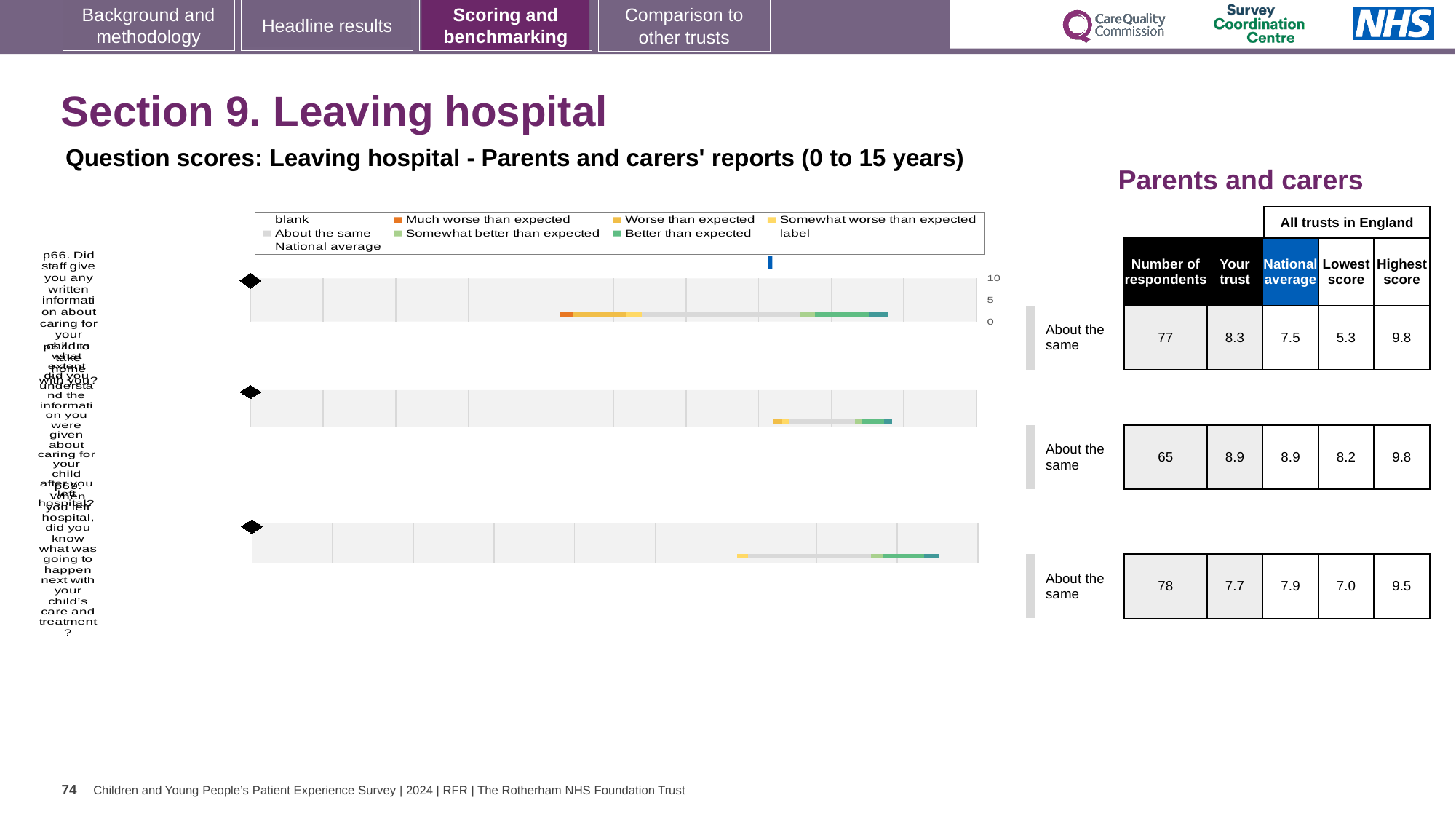
For the first (top) question row, what is the 'Your trust' score? 8.3 For the second (middle) question row, how many respondents are there? 65 What kind of chart is used to show the benchmark ranges on this slide? bar chart Which question row has the fewest respondents? the second (middle) row For the third (bottom) question row, what is the lowest score across all trusts in England? 7.0 For the third (bottom) question row, is the 'Your trust' score or the national average higher? national average For the first (top) question row, what is the national average score? 7.5 How many benchmark bar charts are shown on the slide? 3 In the chart legend, which colour represents 'Much worse than expected'? orange What is the title of the table to the right of the charts? Parents and carers For the first (top) question row, what is the difference between the 'Your trust' score and the national average? 0.8 Which question row has the highest 'Your trust' score? the second (middle) row